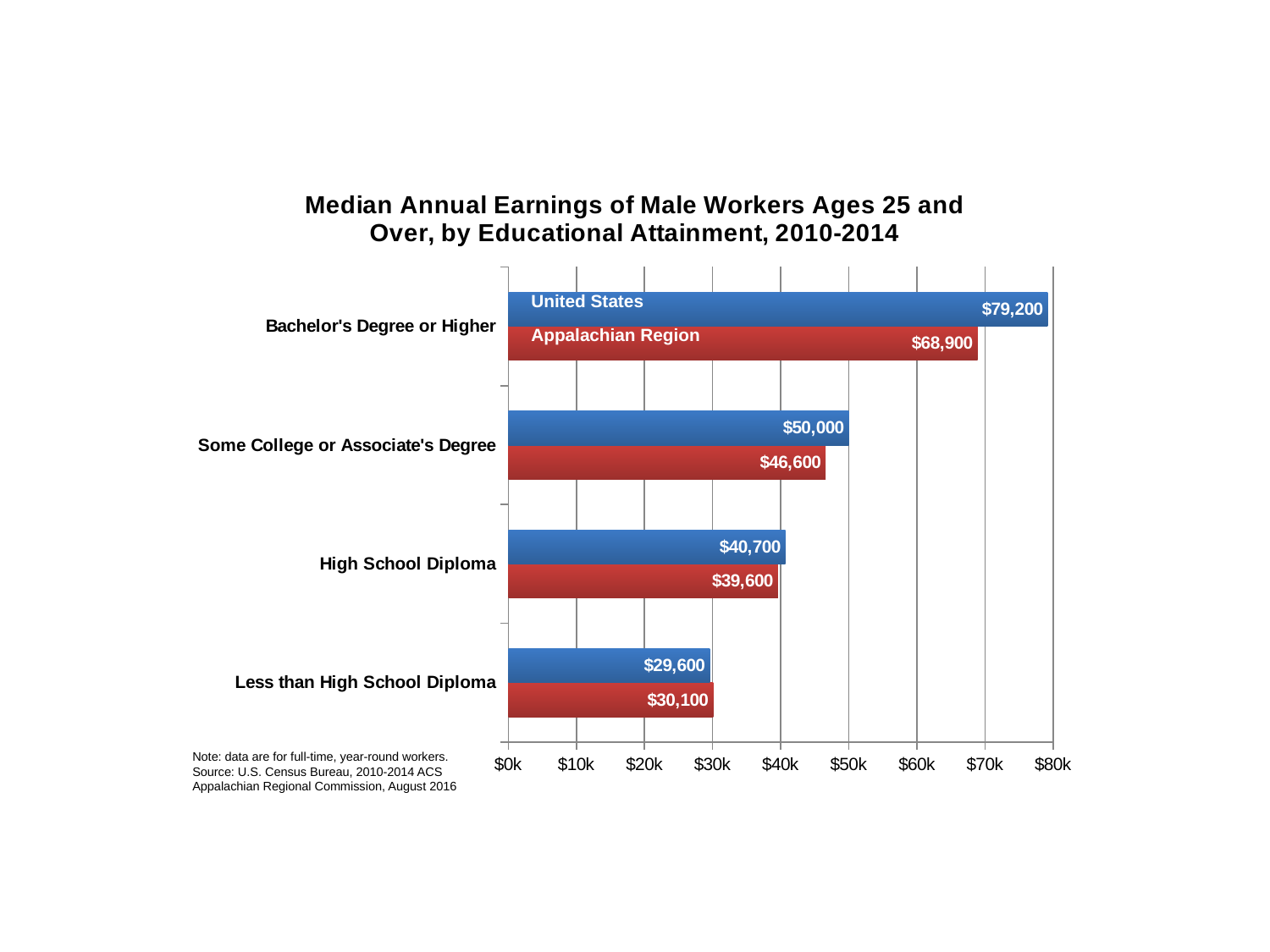
How many educational attainment categories are shown on the chart? 4 Which educational attainment category has the highest median annual earnings for the United States? Bachelor's Degree or Higher What is the median annual earnings for Appalachian Region male workers with Some College or Associate's Degree? $46,600 Which educational attainment category has the lowest median annual earnings for the Appalachian Region? Less than High School Diploma What is the difference between United States and Appalachian Region median earnings for Some College or Associate's Degree? $3,400 Which colour represents the Appalachian Region series? Red How many data series does the chart show? 2 What is the median annual earnings for Appalachian Region male workers with a High School Diploma? $39,600 For Less than High School Diploma, which is larger: the United States value or the Appalachian Region value? Appalachian Region What type of chart is shown on the slide? Bar chart What is the median annual earnings for United States male workers with a Bachelor's Degree or Higher? $79,200 What is the difference between United States and Appalachian Region median earnings for Bachelor's Degree or Higher? $10,300